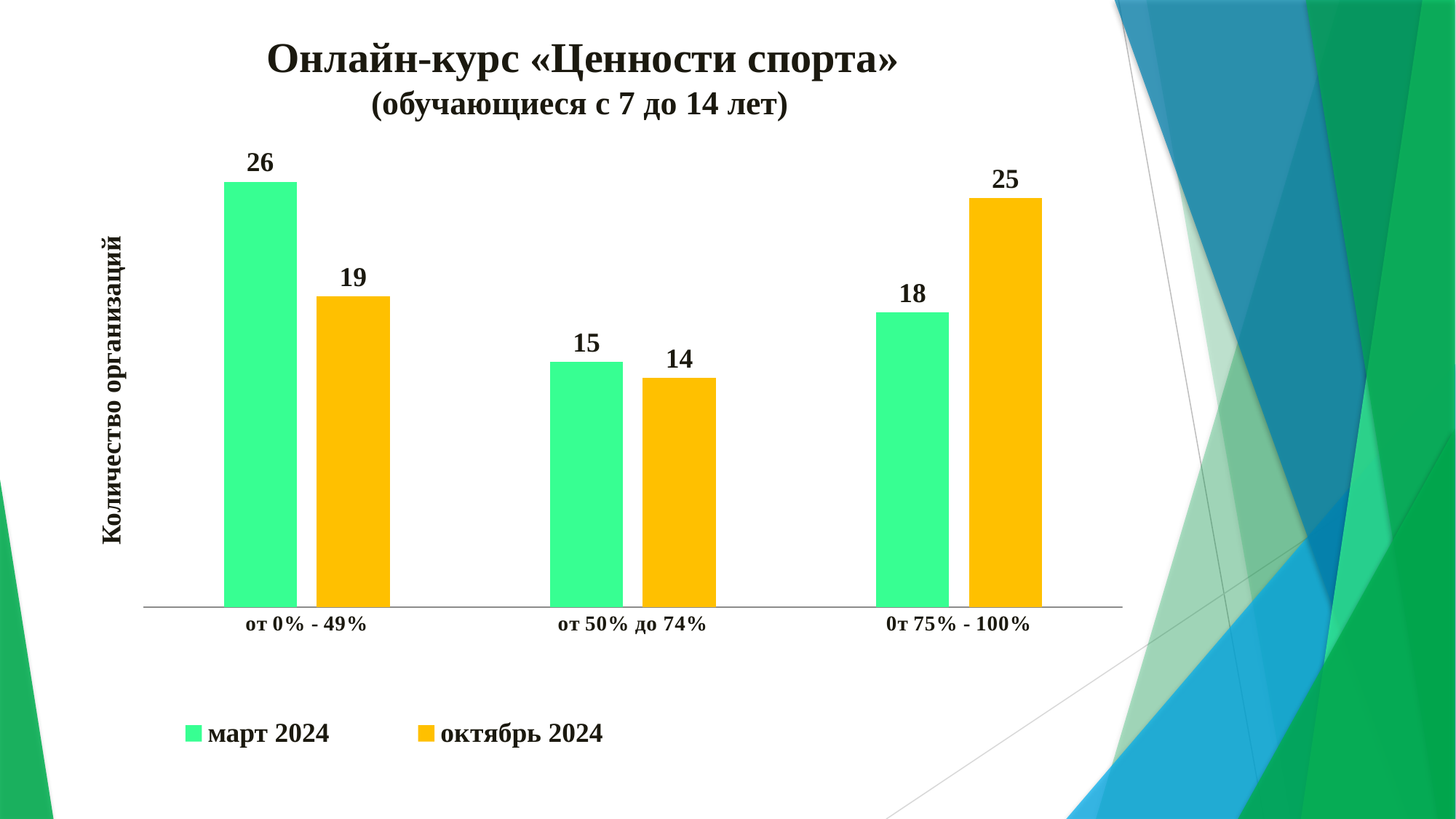
What is the value for март 2024 in the category от 0% - 49%? 26 How many categories are shown on the x axis? 3 Which is larger in the category от 75% - 100%: март 2024 or октябрь 2024? октябрь 2024 What is the value for март 2024 in the category от 75% - 100%? 18 What is the label of the vertical axis? Количество организаций What is the value for октябрь 2024 in the category от 75% - 100%? 25 What is the difference between март 2024 and октябрь 2024 in the category от 0% - 49%? 7 Which category has the highest value for март 2024? от 0% - 49% Which category has the lowest value for октябрь 2024? от 50% до 74% What is the value for октябрь 2024 in the category от 50% до 74%? 14 How many series does the legend list? 2 What kind of chart is shown on the slide? bar chart